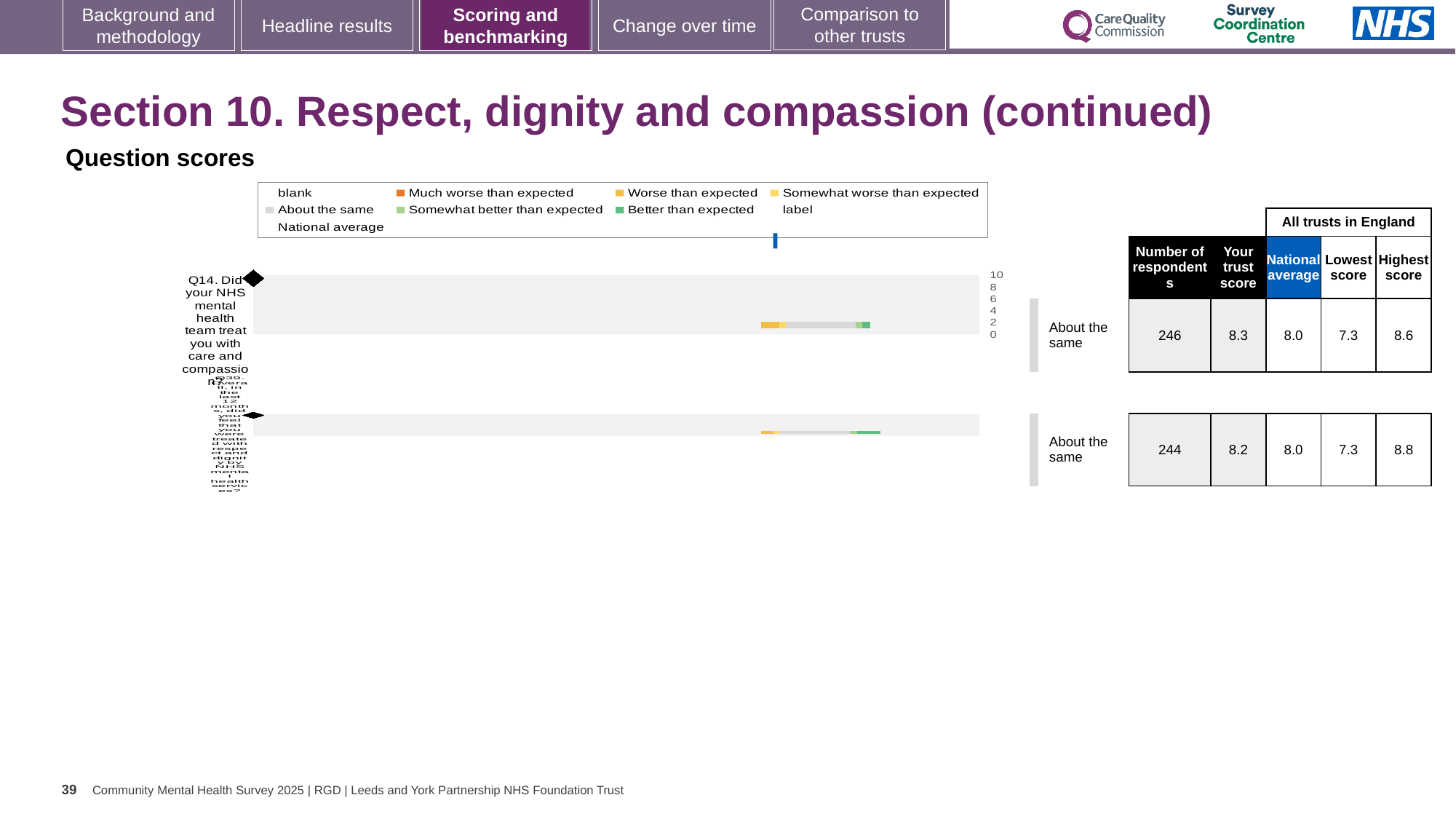
What is the national average score for Q39? 8.0 How many respondents answered Q14? 246 What benchmark category is shown for Q14? About the same What is the trust score for Q14 (treated with care and compassion)? 8.3 How many questions are plotted in the chart? 2 What is the lowest score among all trusts in England for Q14? 7.3 Which question has the higher highest score across all trusts, Q14 or Q39? Q39 What is the difference between the highest and lowest scores for Q39? 1.5 What is the highest score among all trusts in England for Q39? 8.8 Which question has the higher trust score, Q14 or Q39? Q14 How many respondents answered Q39? 244 What is the difference between the trust score and the national average for Q14? 0.3